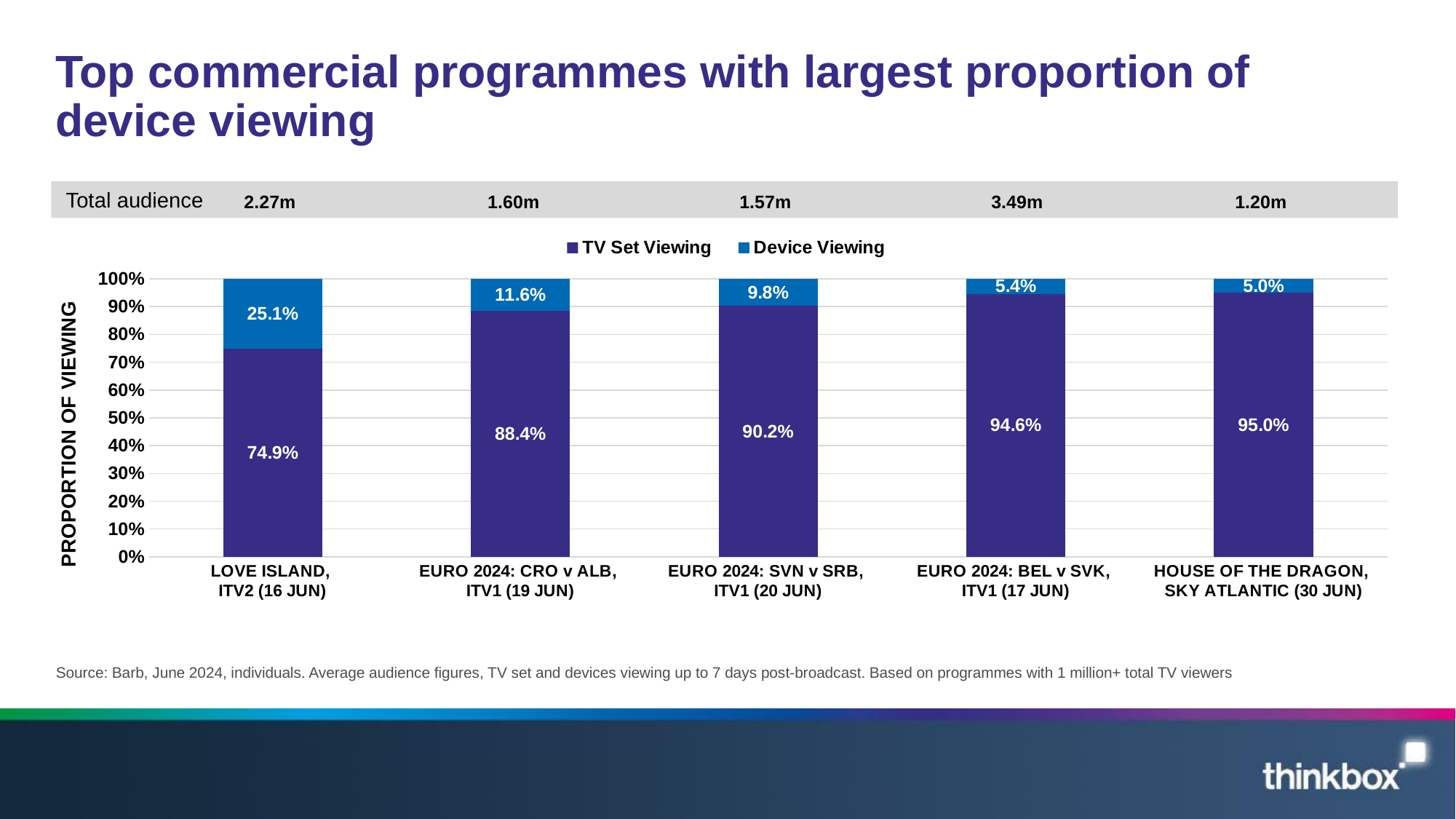
Which programme has the lowest TV Set Viewing share? LOVE ISLAND, ITV2 (16 JUN) What is the Device Viewing share for LOVE ISLAND, ITV2 (16 JUN)? 25.1% How many programmes are shown on the chart? 5 What kind of chart is shown on the slide? Stacked bar chart What is the TV Set Viewing share for EURO 2024: SVN v SRB, ITV1 (20 JUN)? 90.2% Which programme has the highest Device Viewing share? LOVE ISLAND, ITV2 (16 JUN) What is the Device Viewing share for HOUSE OF THE DRAGON, SKY ATLANTIC (30 JUN)? 5.0% Which has a larger TV Set Viewing share, EURO 2024: BEL v SVK or EURO 2024: CRO v ALB? EURO 2024: BEL v SVK What is the difference between the Device Viewing shares of EURO 2024: CRO v ALB and EURO 2024: SVN v SRB? 1.8% How many series does the legend list? 2 What is the total audience shown for EURO 2024: BEL v SVK, ITV1 (17 JUN)? 3.49m Does the Device Viewing share rise or fall moving from left to right across the programmes? Fall